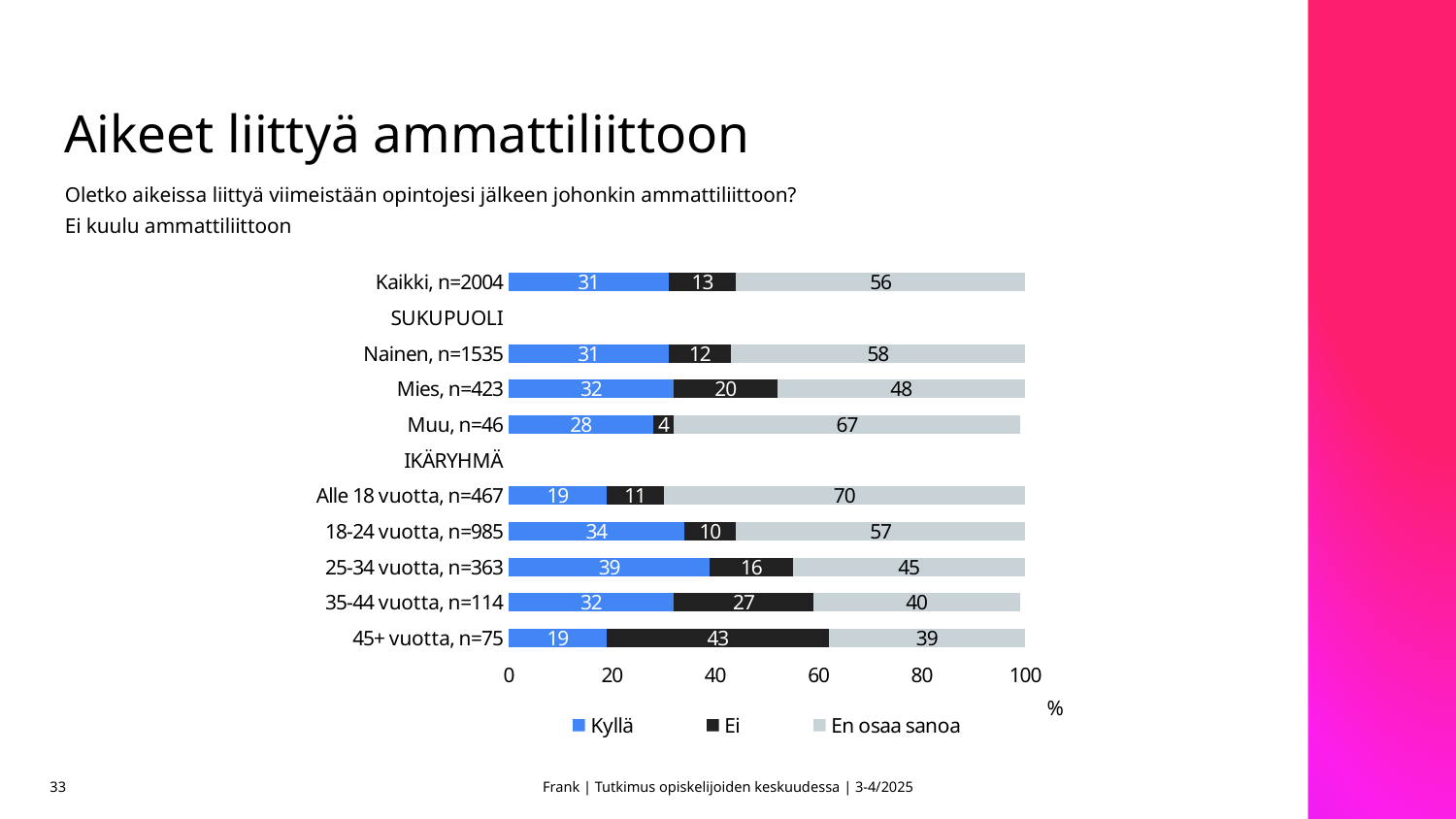
How many series does the legend list? 3 What is the En osaa sanoa value for Muu, n=46? 67 What is the Kyllä value for Kaikki, n=2004? 31 What is the Ei value for 45+ vuotta, n=75? 43 Which category has the highest Kyllä value? 25-34 vuotta, n=363 Which is larger, the Ei value for Mies, n=423 or the Ei value for Nainen, n=1535? Mies, n=423 Which category has the lowest Ei value? Muu, n=46 What kind of chart is shown on the slide? Stacked bar chart What is the total of the stacked bar for 18-24 vuotta, n=985? 101 What is the difference between the En osaa sanoa values for Alle 18 vuotta, n=467 and 45+ vuotta, n=75? 31 Is the En osaa sanoa value for 35-44 vuotta, n=114 greater or less than 60? less What is the title of the chart on the slide? Aikeet liittyä ammattiliittoon